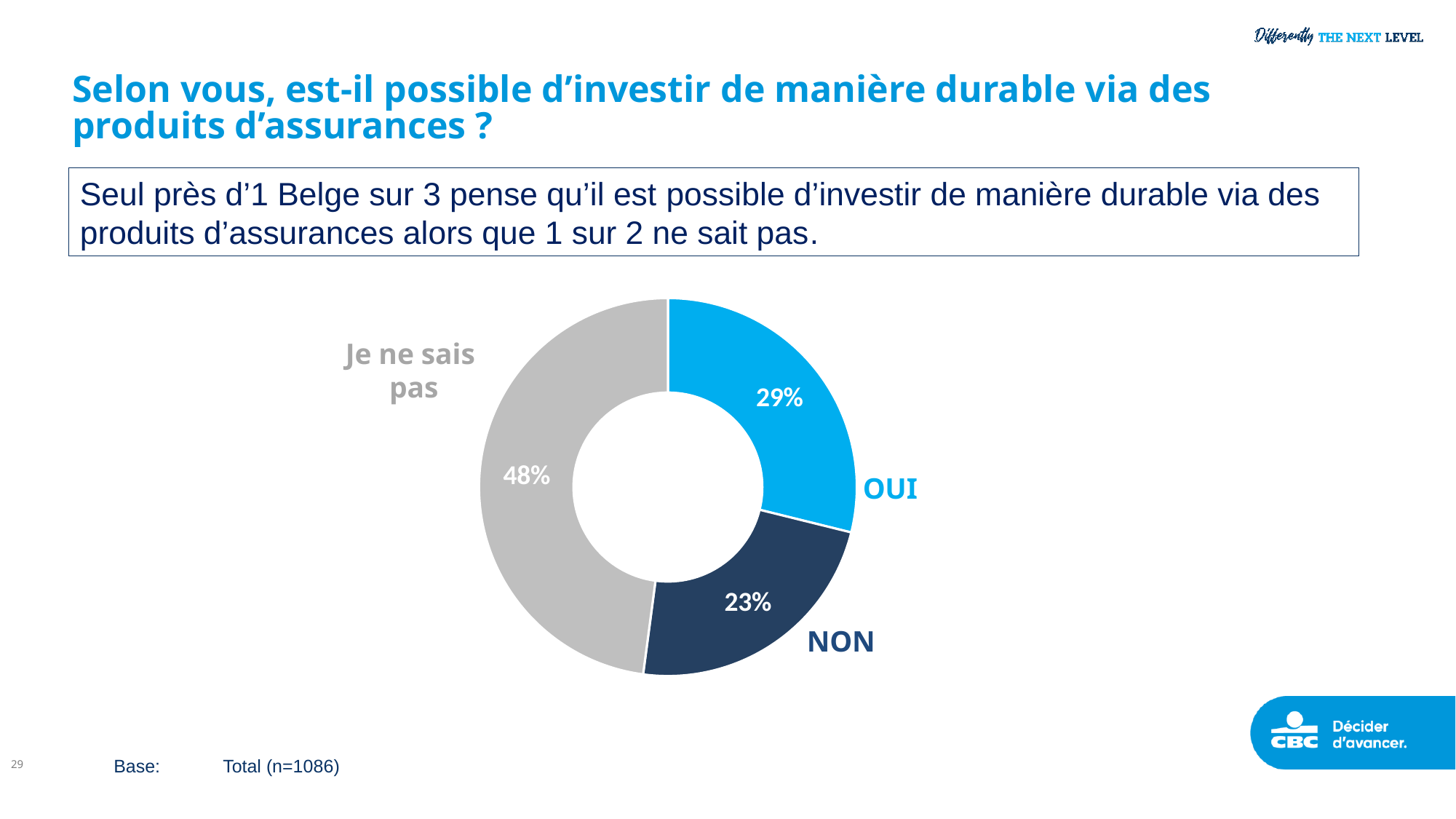
What is the difference in percentage points between OUI and NON? 6 Which is larger, the share for OUI or the share for NON? OUI How many response categories are shown in the chart? 3 What percentage of respondents answered Je ne sais pas? 48% Which response has the smallest share of the chart? NON What is the difference in percentage points between Je ne sais pas and OUI? 19 What percentage of respondents answered NON? 23% What percentage of respondents answered OUI? 29% What kind of chart is shown on the slide? Pie chart (donut) Which response has the largest share of the chart? Je ne sais pas What is the combined share of OUI and NON? 52% What colour is the OUI slice of the chart? Light blue